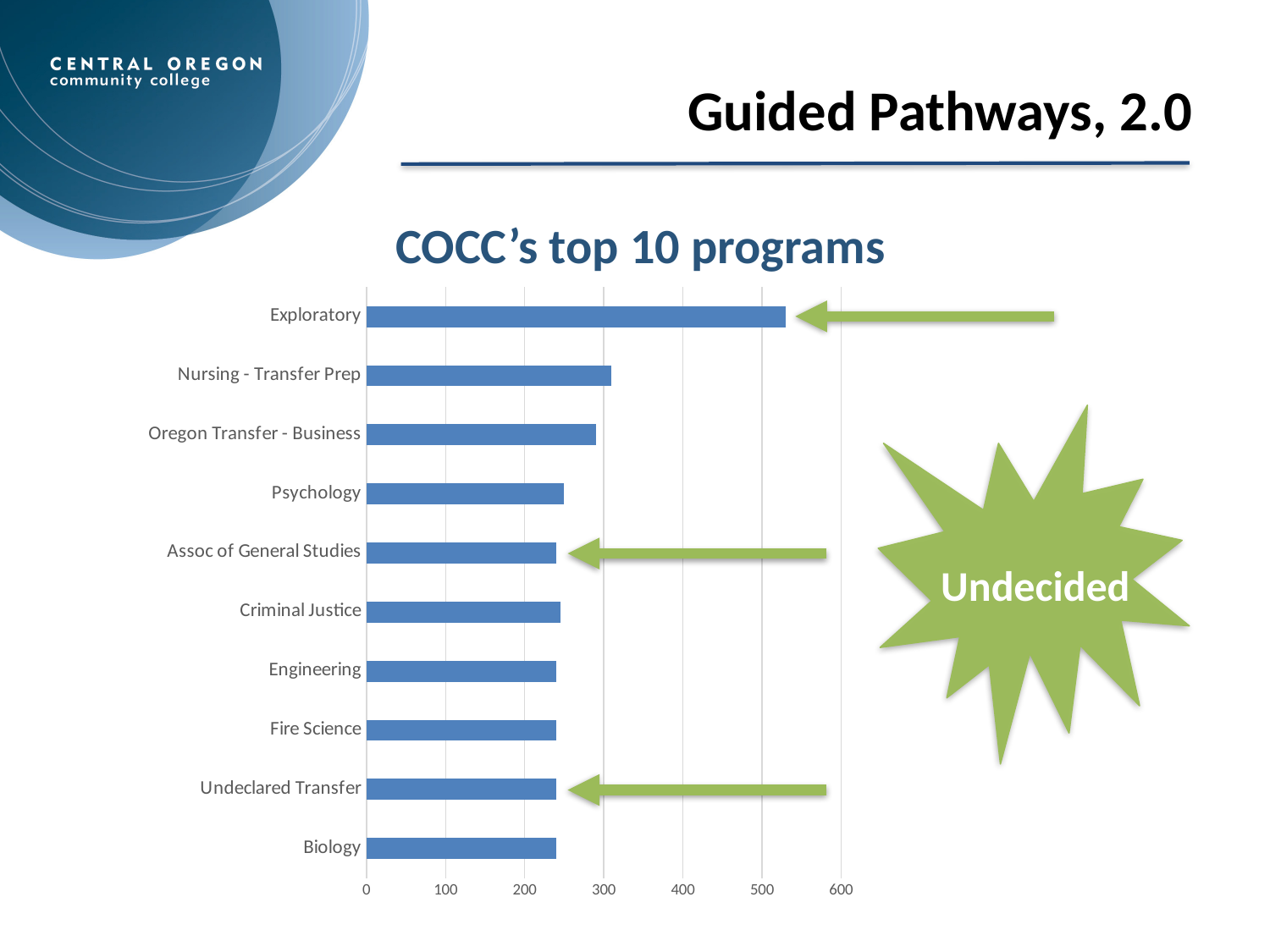
Is the value for Psychology greater or less than 200? greater Which has a larger value, Nursing - Transfer Prep or Psychology? Nursing - Transfer Prep Is the value for Biology greater or less than 300? less What is the highest value shown on the horizontal axis of the chart? 600 Is the value for Exploratory greater or less than 500? greater Which program has the highest value in the chart? Exploratory Which has a larger value, Exploratory or Nursing - Transfer Prep? Exploratory What kind of chart is shown on the slide? bar chart What is the title of the chart? COCC's top 10 programs How many programs are plotted in the chart? 10